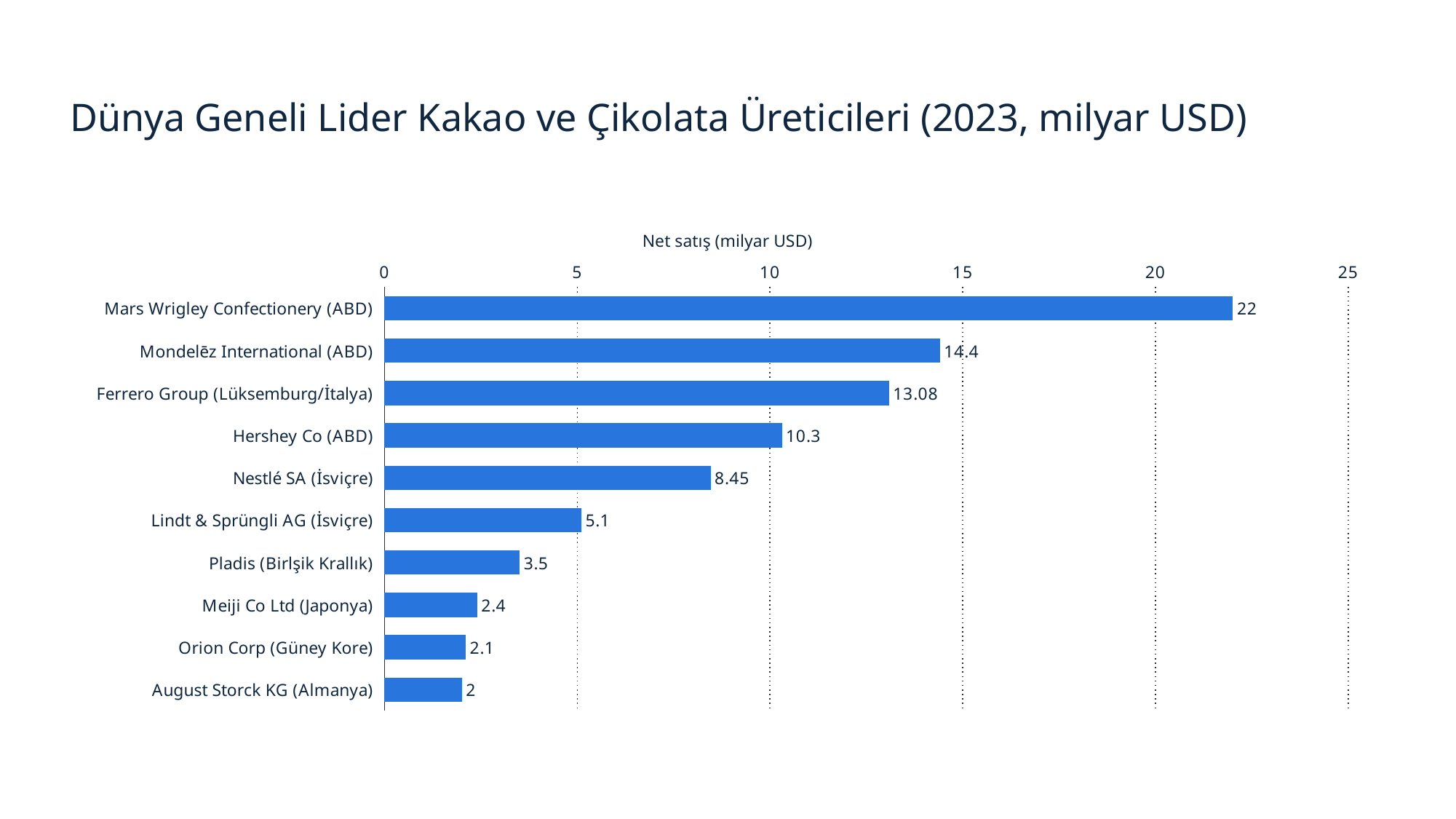
What is the net sales value for Nestlé SA (İsviçre)? 8.45 What is the difference between the net sales of Mars Wrigley Confectionery (ABD) and Mondelēz International (ABD)? 7.6 Which company has the highest net sales? Mars Wrigley Confectionery (ABD) What is the difference between the net sales of Ferrero Group (Lüksemburg/İtalya) and Hershey Co (ABD)? 2.78 Is the value for Hershey Co (ABD) greater or less than 10? greater What is the net sales value for Pladis (Birlşik Krallık)? 3.5 What is the label of the value axis? Net satış (milyar USD) What kind of chart is shown on the slide? Bar chart Which company has the lowest net sales? August Storck KG (Almanya) How many companies are shown in the chart? 10 Which has higher net sales, Lindt & Sprüngli AG (İsviçre) or Meiji Co Ltd (Japonya)? Lindt & Sprüngli AG (İsviçre) What is the net sales value for Mondelēz International (ABD)? 14.4